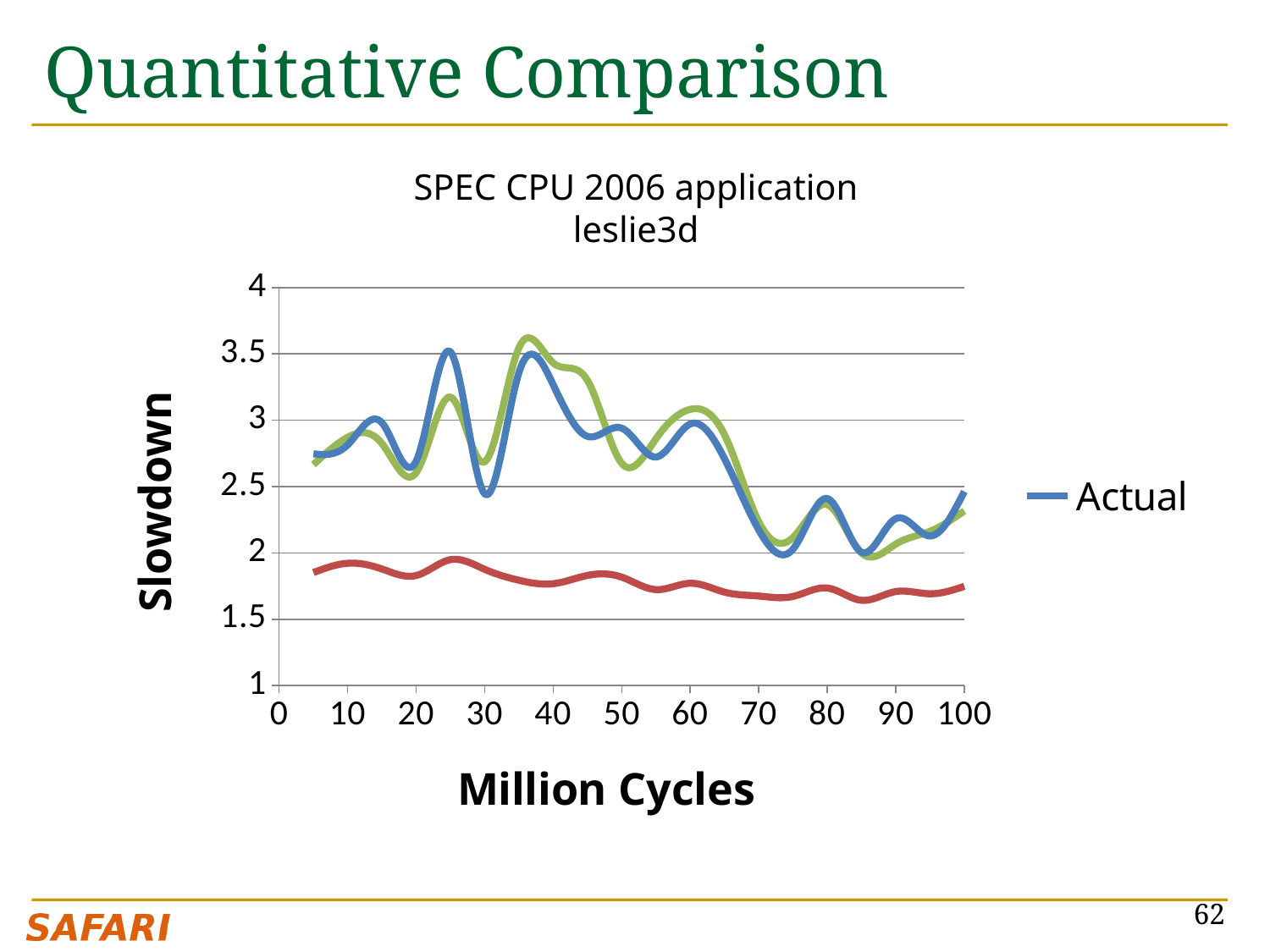
At 50 million cycles, which is larger: the Actual line or the red line? Actual Is the value of the Actual line at 25 million cycles greater or less than 3? greater Is the value of the Actual line at 10 million cycles greater or less than 2.5? greater Is the value of the Actual line at 75 million cycles greater or less than 2.5? less How many series does the chart's legend list? 1 Does the Actual line end at 100 million cycles higher or lower than it starts at 5 million cycles? lower What kind of chart is shown on the slide? line chart What is the label of the y axis? Slowdown What is the title of the chart? SPEC CPU 2006 application leslie3d